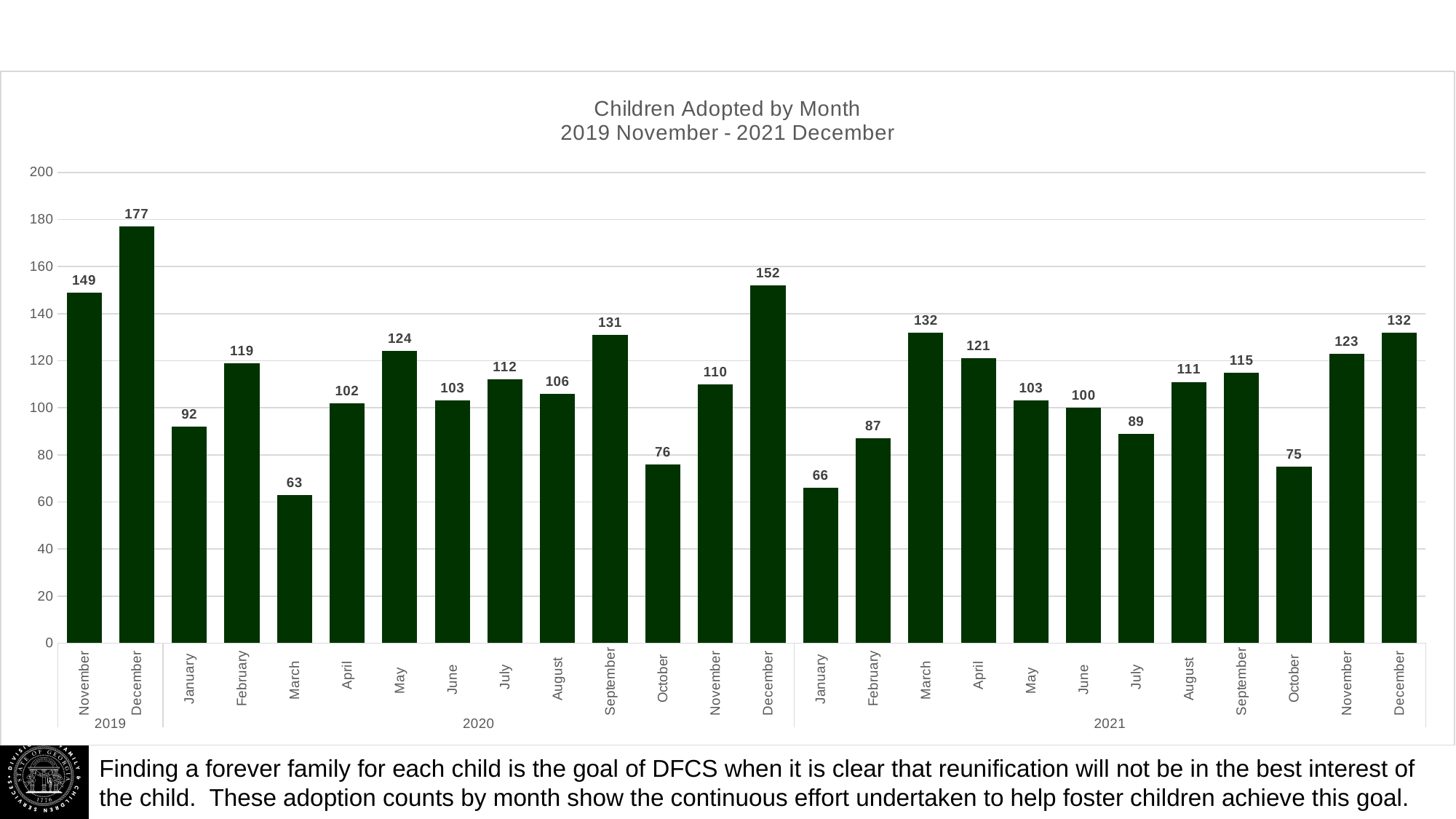
What is the title of the chart? Children Adopted by Month 2019 November - 2021 December Which month has the highest number of children adopted? December 2019 What is the difference between December 2020 and January 2021? 86 Which is larger, the value for September 2020 or the value for September 2021? September 2020 What is the value for March 2020? 63 What is the value shown for October 2021? 75 How many monthly bars are plotted on the chart? 26 What is the difference between December 2019 and November 2019? 28 How many children were adopted in December 2020? 152 How many children were adopted in December 2019? 177 Which month has the lowest number of children adopted? March 2020 What type of chart is shown on the slide? Bar chart